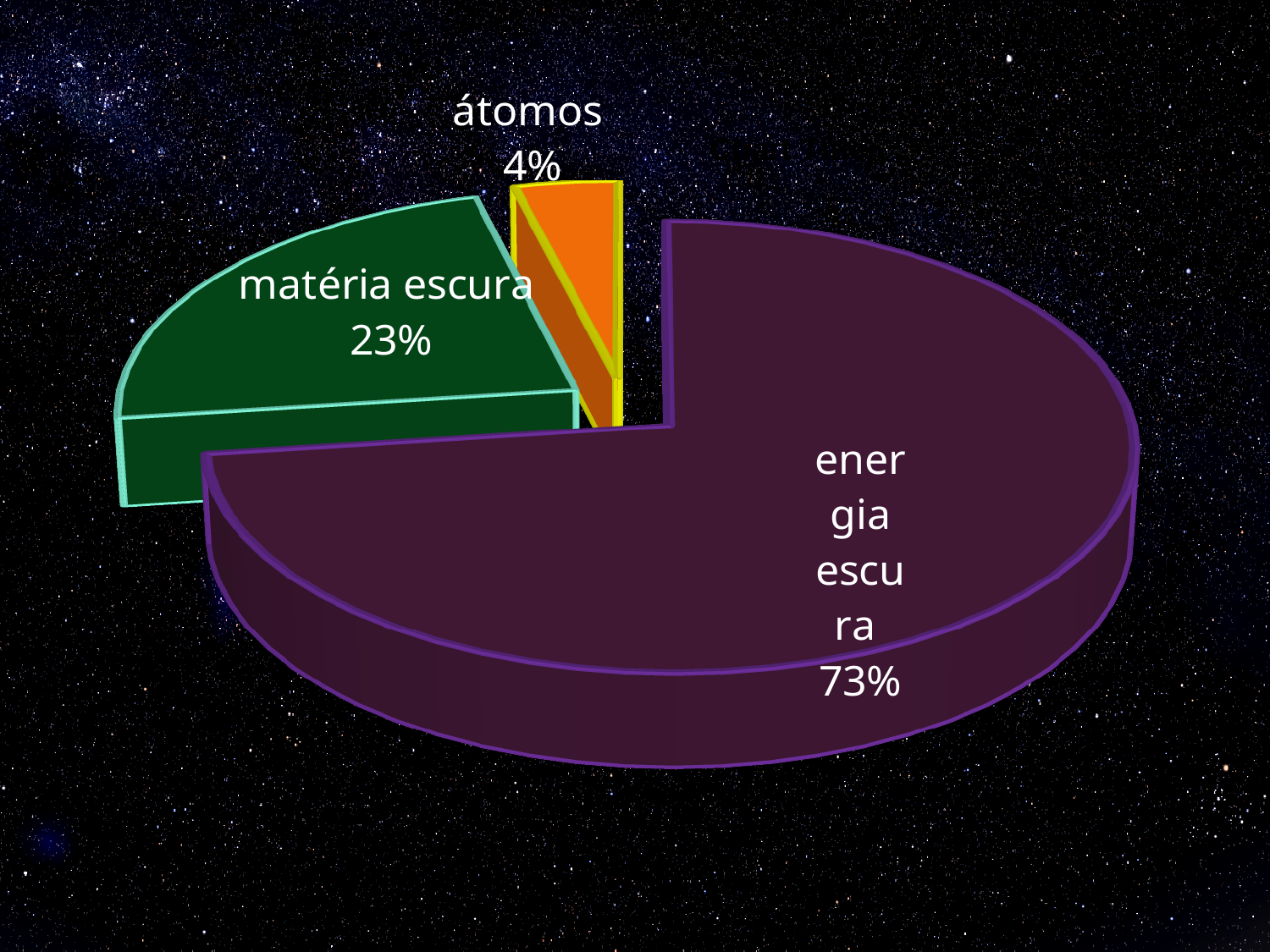
Which slice of the pie is the largest? energia escura How many slices does the pie chart have? 3 What colour is the 'átomos' slice? orange What is the difference in percentage points between 'matéria escura' and 'átomos'? 19 What colour is the 'matéria escura' slice? green Which slice of the pie is the smallest? átomos What kind of chart is shown on the slide? pie chart What is the difference in percentage points between 'energia escura' and 'matéria escura'? 50 What percentage does the 'matéria escura' slice represent? 23% Which is larger, the 'matéria escura' slice or the 'átomos' slice? matéria escura What percentage does the 'átomos' slice represent? 4% What percentage does the 'energia escura' slice represent? 73%